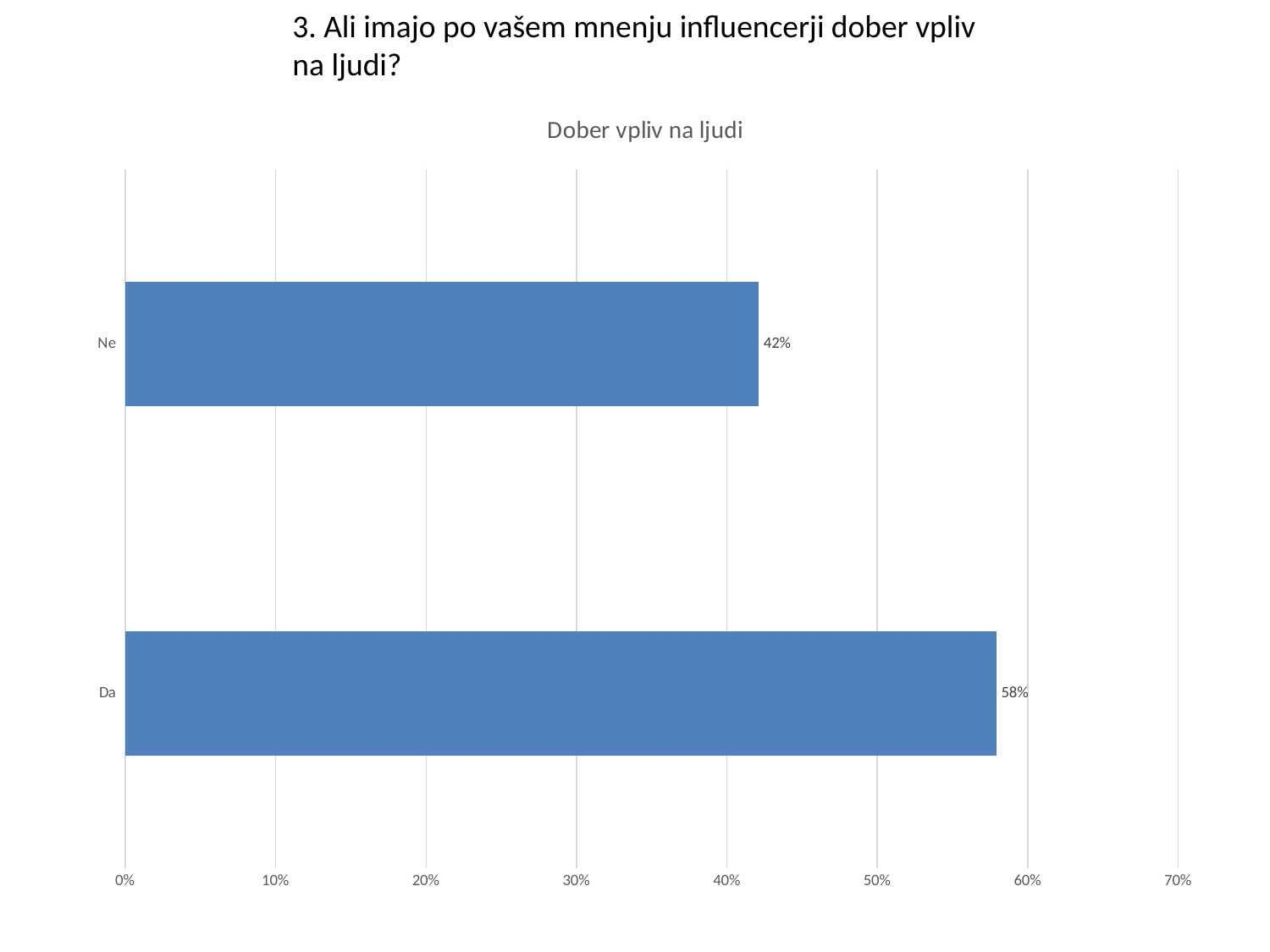
What is the title of the chart? Dober vpliv na ljudi Which category has the lowest value? Ne Is the value for Da greater or less than 50%? greater Which is larger, the value for Da or the value for Ne? Da What is the highest value shown on the x axis? 70% Is the value for Ne greater or less than 50%? less Which category has the highest value? Da What is the difference between the values for Da and Ne? 16% How many categories are shown in the chart? 2 What kind of chart is shown? bar chart What is the value for Ne? 42% What is the value for Da? 58%